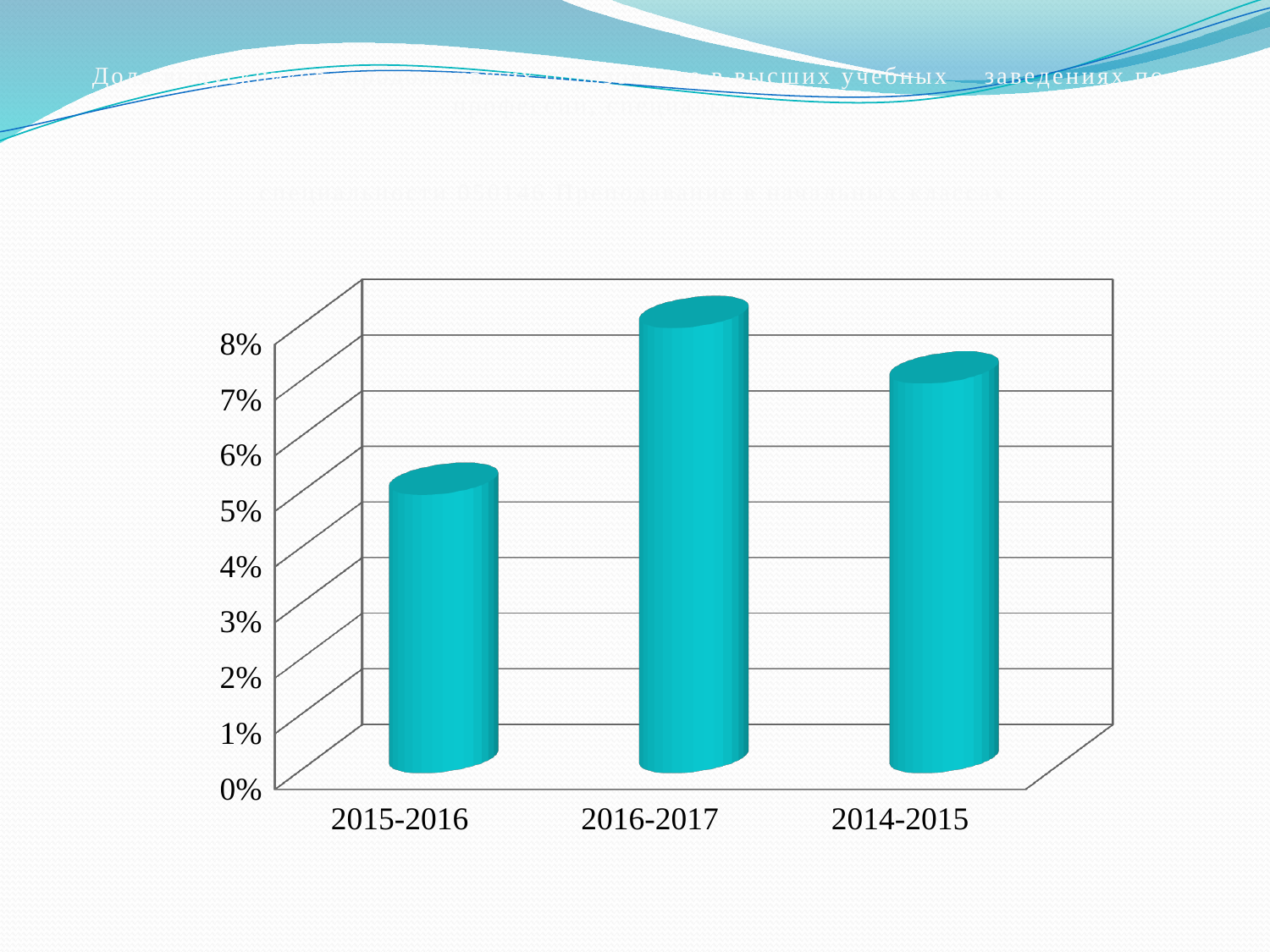
Which is larger, the value for 2015-2016 or the value for 2014-2015? 2014-2015 Is the value for 2015-2016 greater or less than 4%? greater Which category has the lowest bar in the chart? 2015-2016 Is the value for 2016-2017 greater or less than 7%? greater Which is larger, the value for 2016-2017 or the value for 2014-2015? 2016-2017 Is the value for 2015-2016 greater or less than 6%? less Which category has the highest bar in the chart? 2016-2017 What is the highest value shown on the vertical axis of the chart? 8% What kind of chart is shown on the slide? bar chart Does the value rise or fall from 2015-2016 to 2016-2017? rises How many categories are plotted on the x axis of the chart? 3